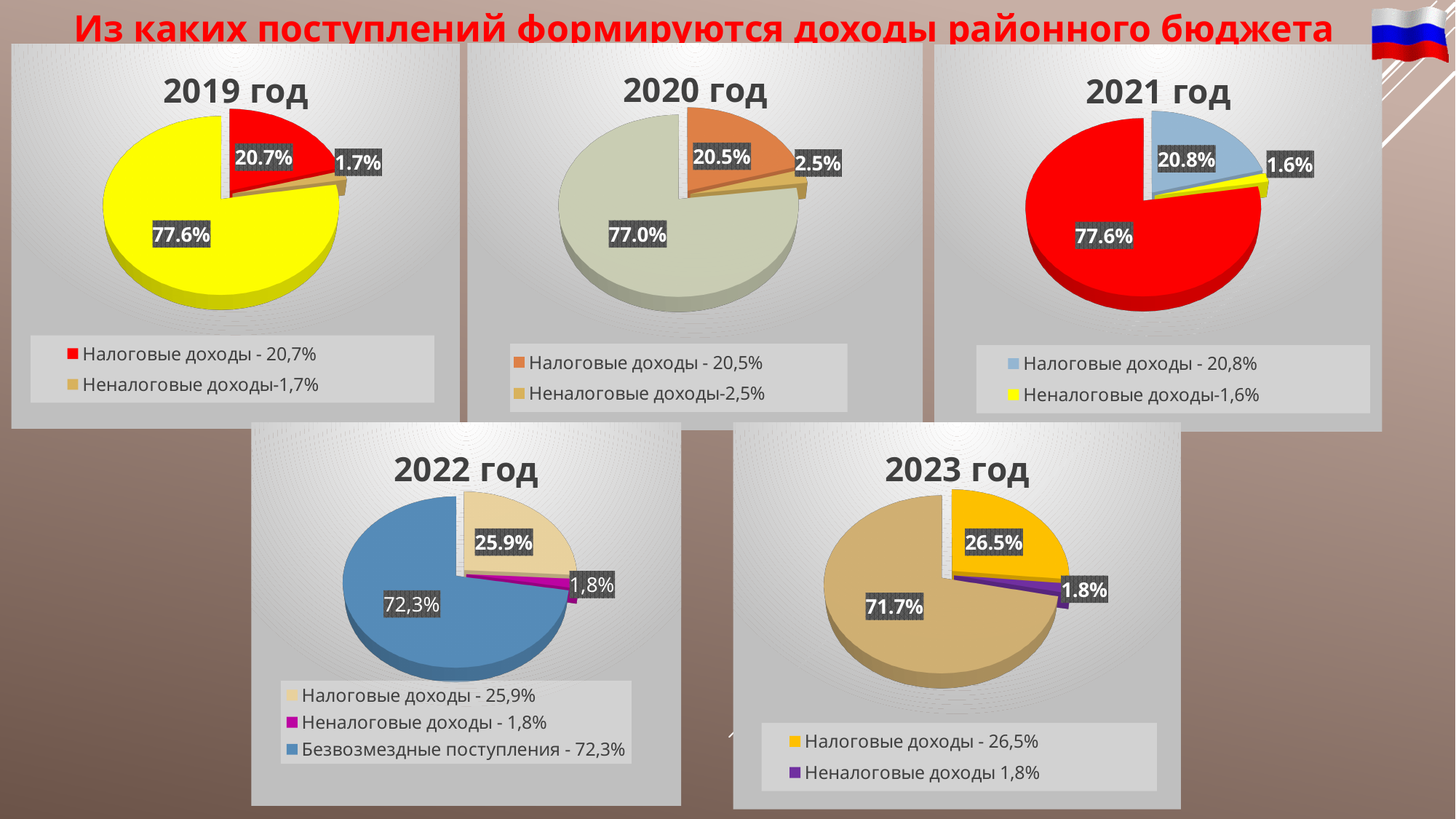
In the 2023 год chart, which of the two legend categories has the smaller slice? Неналоговые доходы In the 2021 год chart, what is the value shown on the largest slice? 77.6% What type of chart is used for the 2020 год chart? Pie chart In the 2022 год chart, which category has the largest slice? Безвозмездные поступления How many slices does the 2022 год chart have? 3 In the 2023 год chart, what is the value shown for Налоговые доходы? 26.5% In the 2020 год chart, what is the value shown for Неналоговые доходы? 2.5% In the 2022 год chart, what is the difference between Налоговые доходы and Неналоговые доходы? 24.1% How many entries does the legend of the 2022 год chart list? 3 In the 2022 год chart, what is the value shown for Безвозмездные поступления? 72,3% In the 2019 год chart, what is the value shown for Налоговые доходы? 20.7% Which is larger: Налоговые доходы in the 2019 год chart or in the 2021 год chart? 2021 год